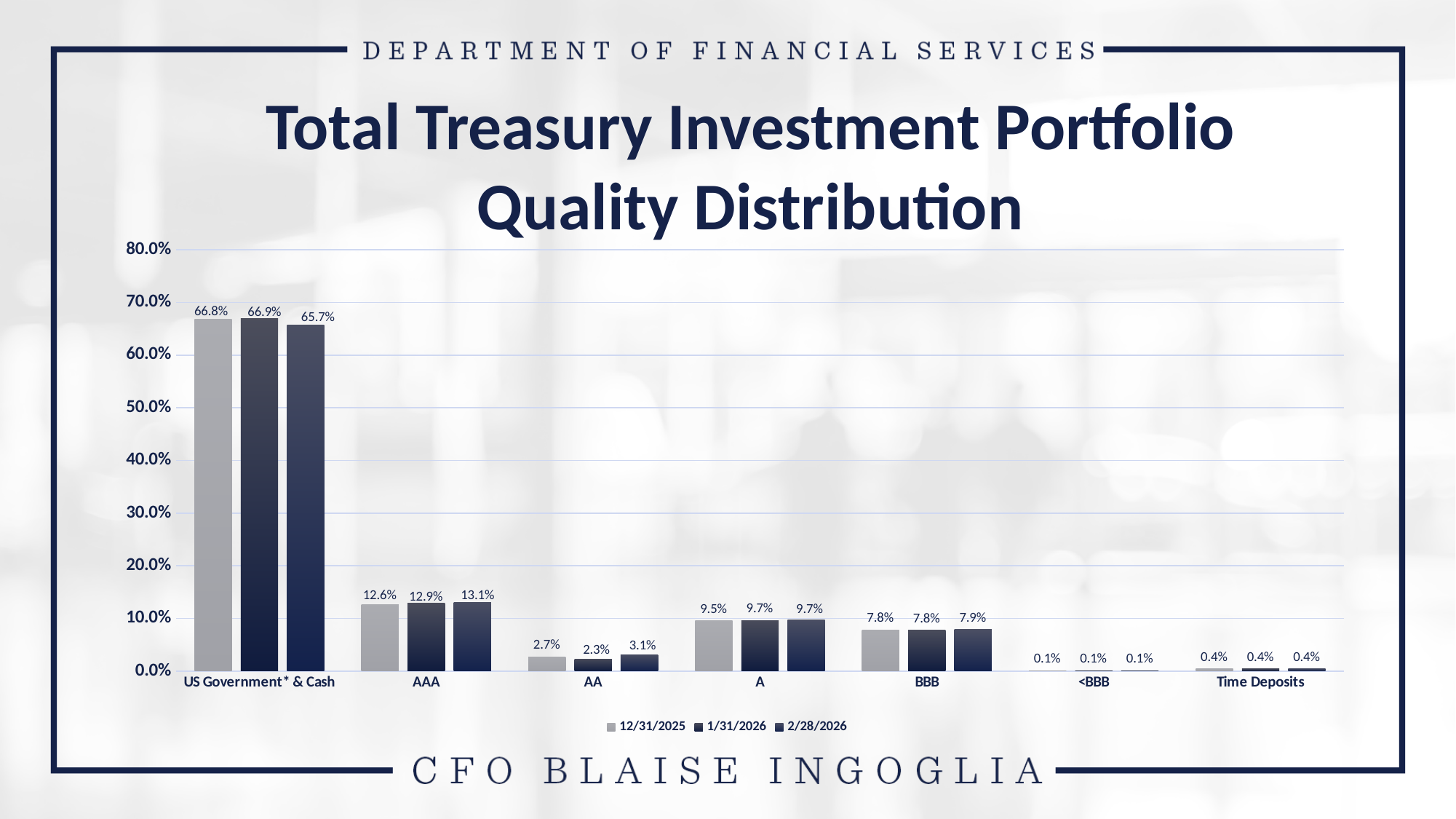
What is the value for Time Deposits in the 12/31/2025 series? 0.4% Which category has the lowest value in the 12/31/2025 series? <BBB What is the value for US Government* & Cash in the 12/31/2025 series? 66.8% How many categories are shown on the x axis? 7 Which category has the highest value in the 2/28/2026 series? US Government* & Cash What is the value for AA in the 1/31/2026 series? 2.3% Which is larger for AA: the 12/31/2025 value or the 2/28/2026 value? 2/28/2026 What kind of chart is shown on the slide? Bar chart What is the title of the chart? Total Treasury Investment Portfolio Quality Distribution How many series does the legend list? 3 What is the difference between the 1/31/2026 and 2/28/2026 values for US Government* & Cash? 1.2% What is the value for AAA in the 2/28/2026 series? 13.1%